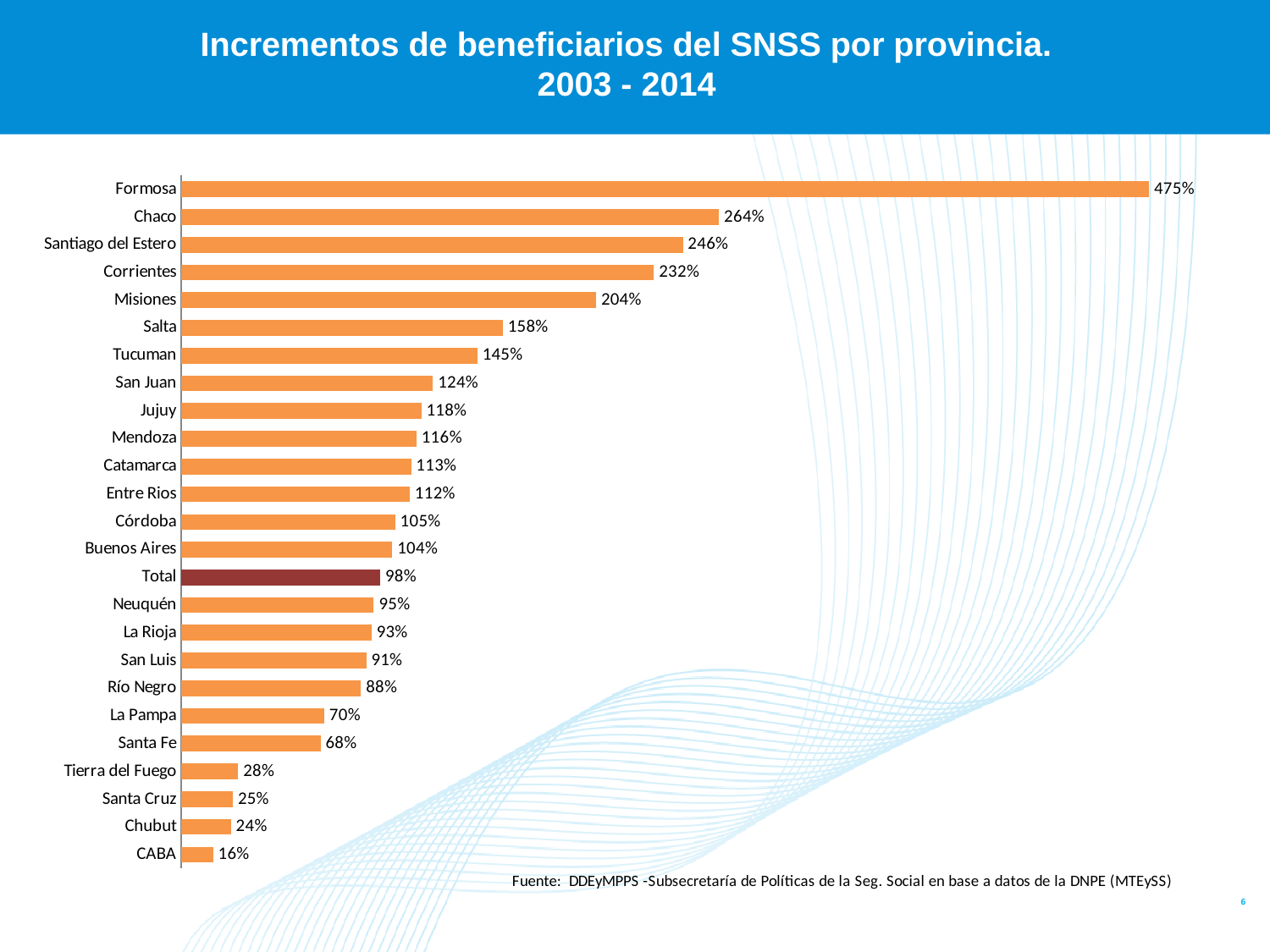
How many bars are plotted in the chart, including the Total bar? 25 What kind of chart is shown on the slide? Bar chart What is the difference between the values for Chaco and Santiago del Estero? 18% Which bar is shown in a different colour (dark red) from the others? Total Which has a larger value, La Pampa or Río Negro? Río Negro What is the difference between the values for Misiones and Salta? 46% What is the value shown for the Total bar? 98% Which category has the lowest value? CABA Which category has the highest value? Formosa What is the value shown for Formosa? 475% What is the value shown for Santa Fe? 68% Which has a larger value, Mendoza or Catamarca? Mendoza